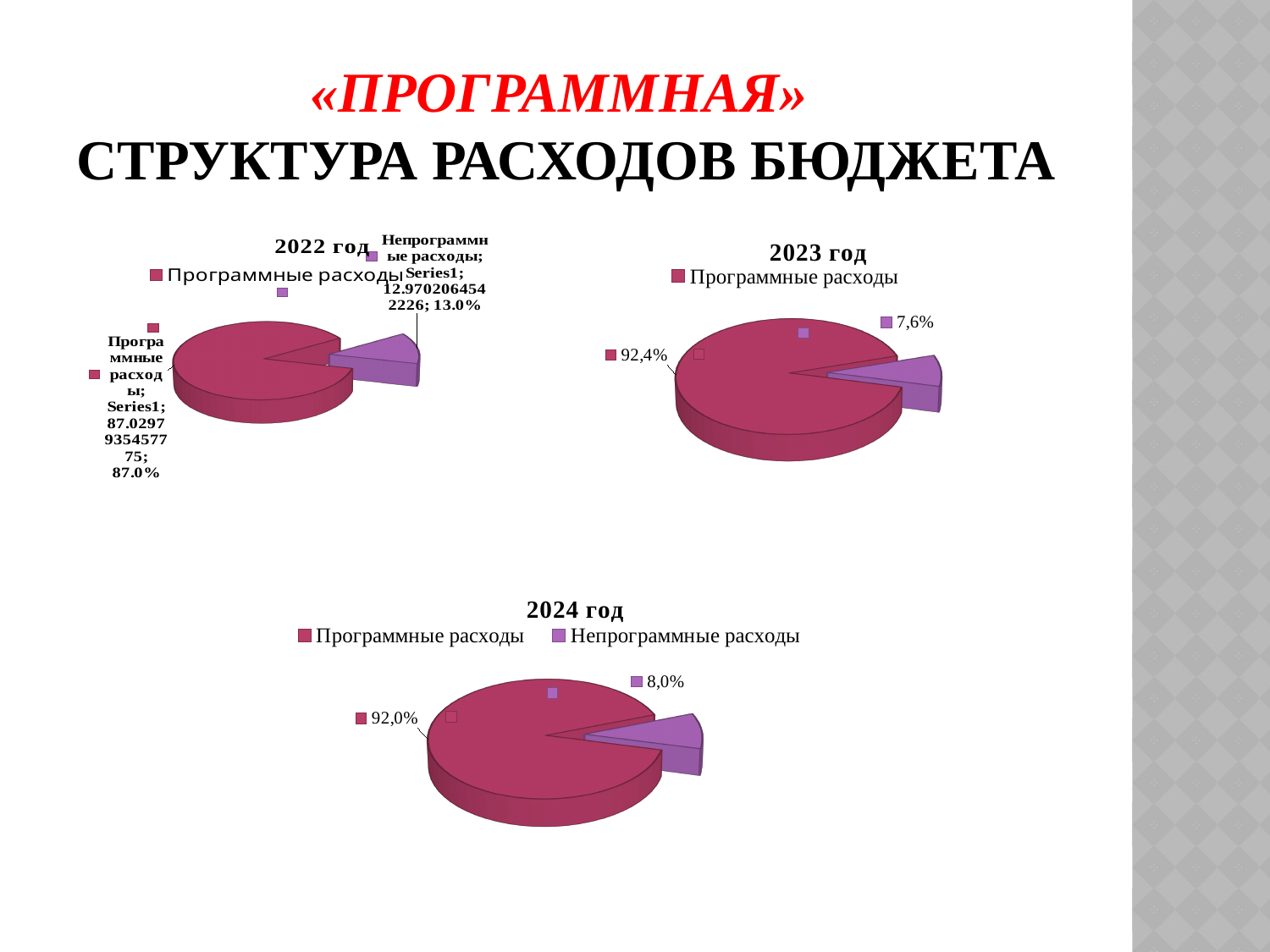
In the 2024 год chart, what share is shown for Программные расходы? 92,0% In the 2022 год chart, what share is shown for Непрограммные расходы? 13.0% In the 2024 год chart, which slice is larger, Программные расходы or Непрограммные расходы? Программные расходы In the 2024 год chart, what share is shown for Непрограммные расходы? 8,0% In the 2023 год chart, what share is shown for Программные расходы? 92,4% What kind of chart is the 2024 год chart? Pie chart How many slices does the 2023 год pie chart have? 2 In the 2023 год chart, what is the value of the smaller slice? 7,6% In the 2024 год chart, what is the difference between the Программные расходы and Непрограммные расходы shares? 84,0% How many pie charts are shown on the slide? 3 In the 2022 год chart, what share is shown for Программные расходы? 87.0% How many entries does the legend of the 2024 год chart list? 2